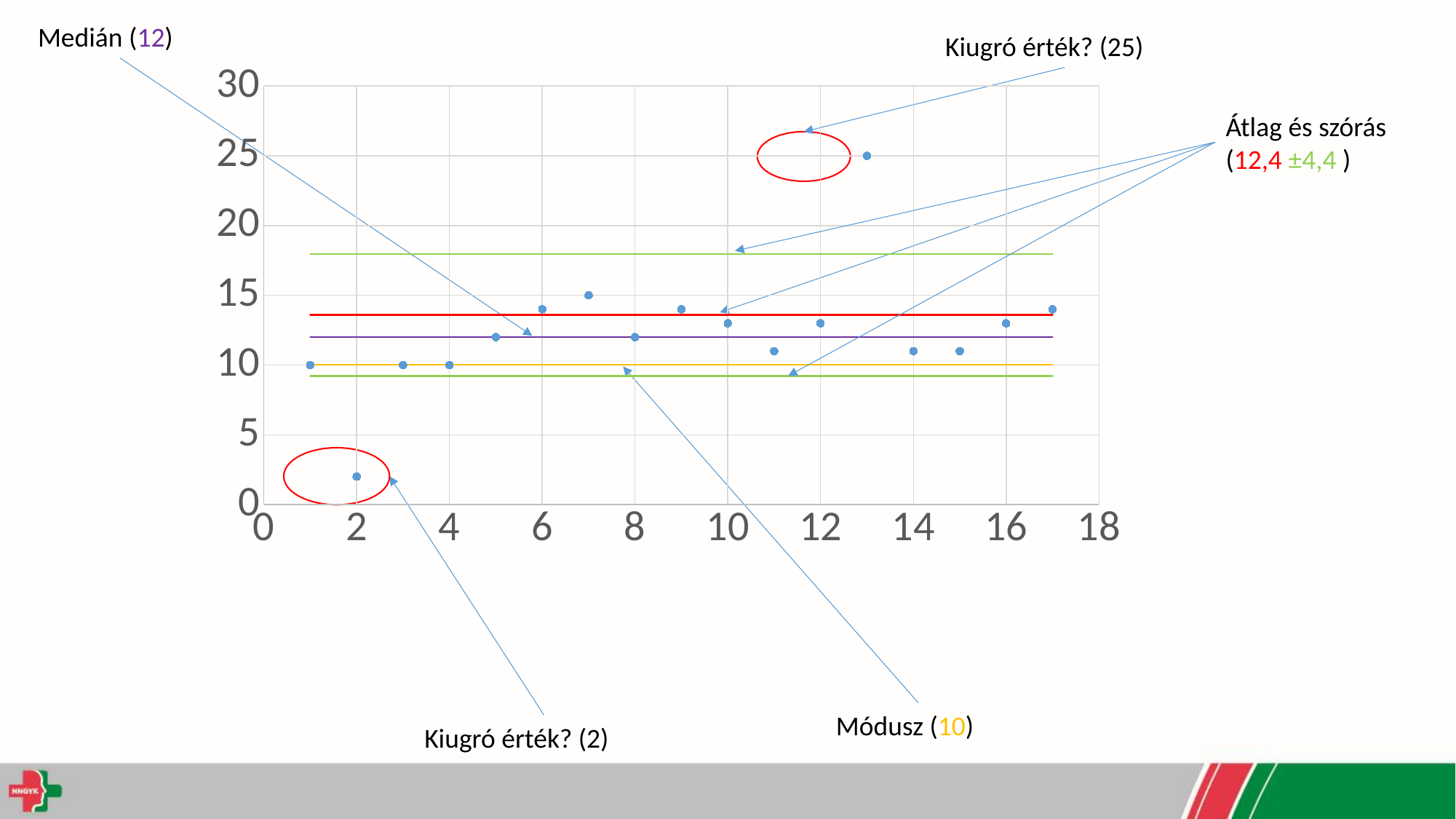
At which x value is the lowest data point located? 2 What is the difference between the high outlier (25) and the low outlier (2)? 23 What is the median (Medián) value given on the slide? 12 What is the standard deviation (szórás) value given on the slide? 4,4 Is the data point at x = 7 greater or less than 10? greater What kind of chart is shown on the slide? scatter chart How many data points are plotted in the chart? 17 What is the mode (Módusz) value given on the slide? 10 What is the value of the low outlier circled in red (Kiugró érték?)? 2 What is the value of the high outlier circled in red (Kiugró érték?)? 25 At which x value is the highest data point located? 13 What is the mean (Átlag) value given on the slide? 12,4